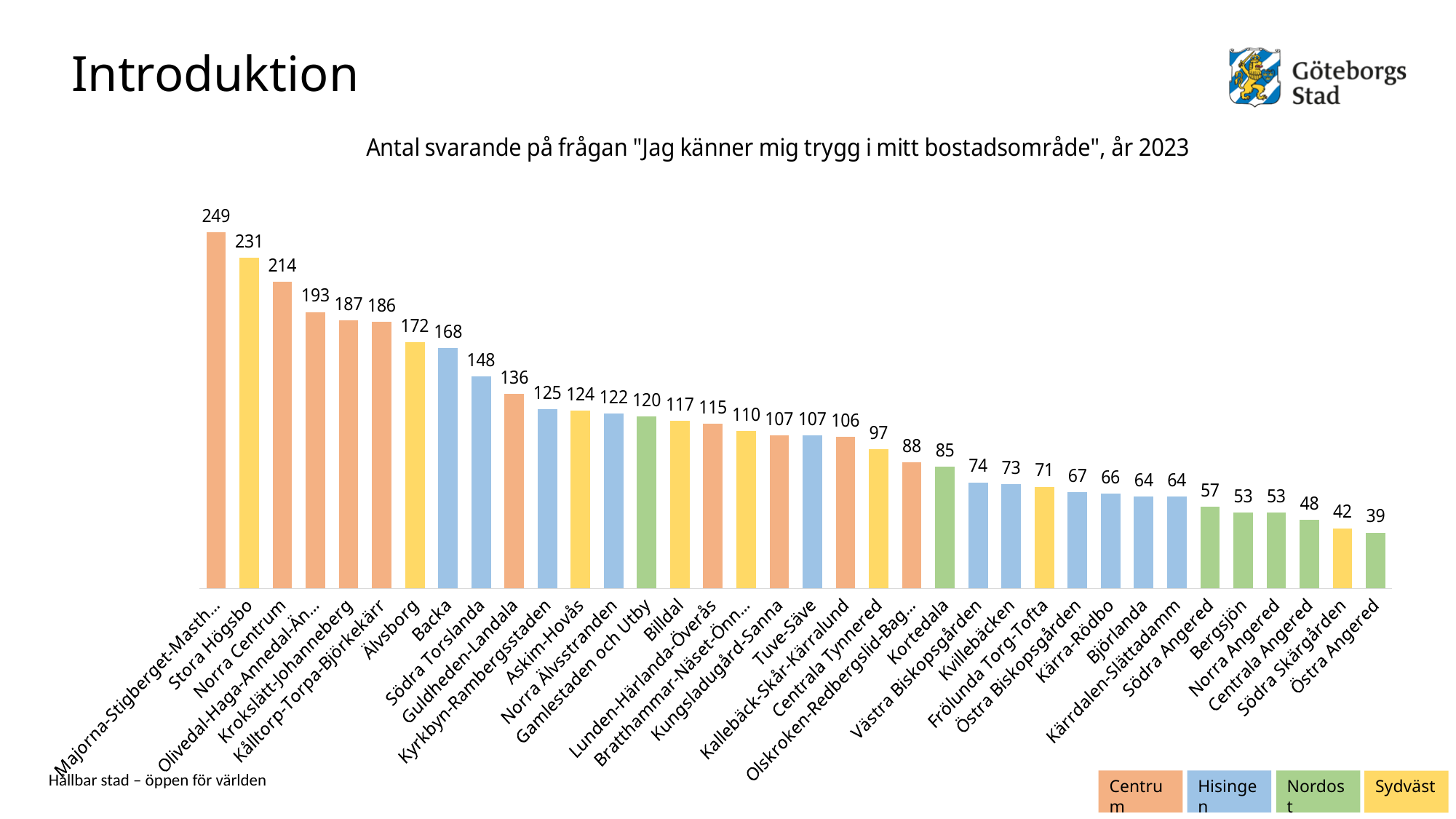
Which has more respondents, Älvsborg or Södra Torslanda? Älvsborg How many respondents are shown for Backa? 168 What is the value for Kortedala? 85 What is the difference between the values for Stora Högsbo and Norra Centrum? 17 What is the value for Frölunda Torg-Tofta? 71 Which has a higher value, Bergsjön or Centrala Angered? Bergsjön How many series does the legend list? 4 Which area has the highest number of respondents? Majorna-Stigberget-Masth... Do the values rise or fall from left to right along the x axis? fall Which area has the lowest number of respondents? Östra Angered Which legend entry is shown in green? Nordost What type of chart is shown on the slide? bar chart